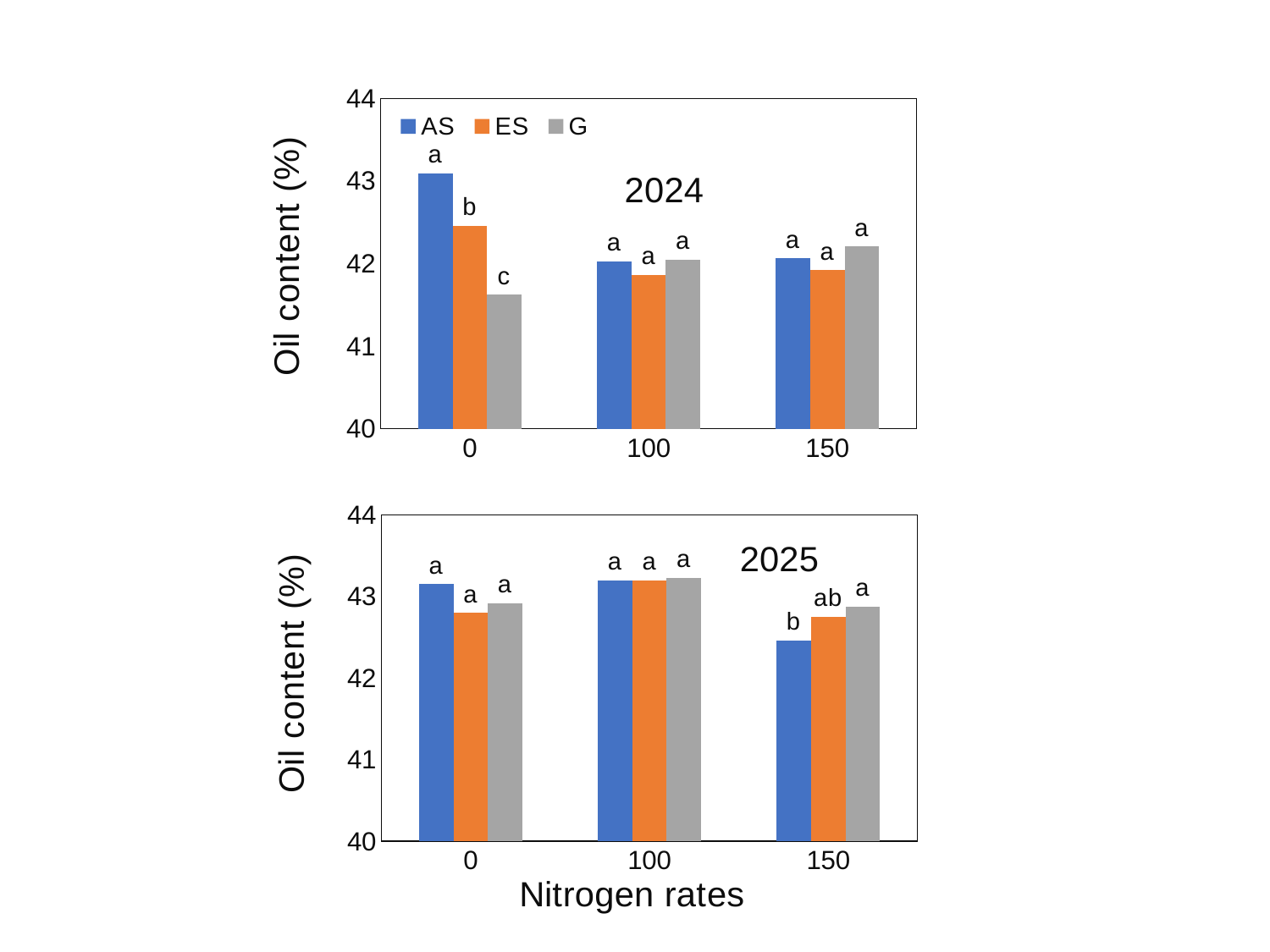
In the 2024 chart, what letter is printed above the G bar at nitrogen rate 0? c In the 2025 chart, which series has the lowest bar across all nitrogen rates? AS at 150 How many series does the legend list in the 2024 chart? 3 In the 2024 chart, is the value for ES at nitrogen rate 0 greater or less than 42? greater In the 2025 chart, is the value for AS at nitrogen rate 150 greater or less than 43? less In the 2025 chart, which is larger at nitrogen rate 150, AS or G? G How many nitrogen rate categories are shown on the x axis of the 2025 chart? 3 What is the x-axis label shown below the 2025 chart? Nitrogen rates In the 2024 chart, which series has the lowest bar at nitrogen rate 0? G In the 2024 chart, which series has the highest bar at nitrogen rate 0? AS What kind of chart is shown in the 2024 panel? Bar chart In the 2024 chart, is the value for G at nitrogen rate 0 greater or less than 42? less